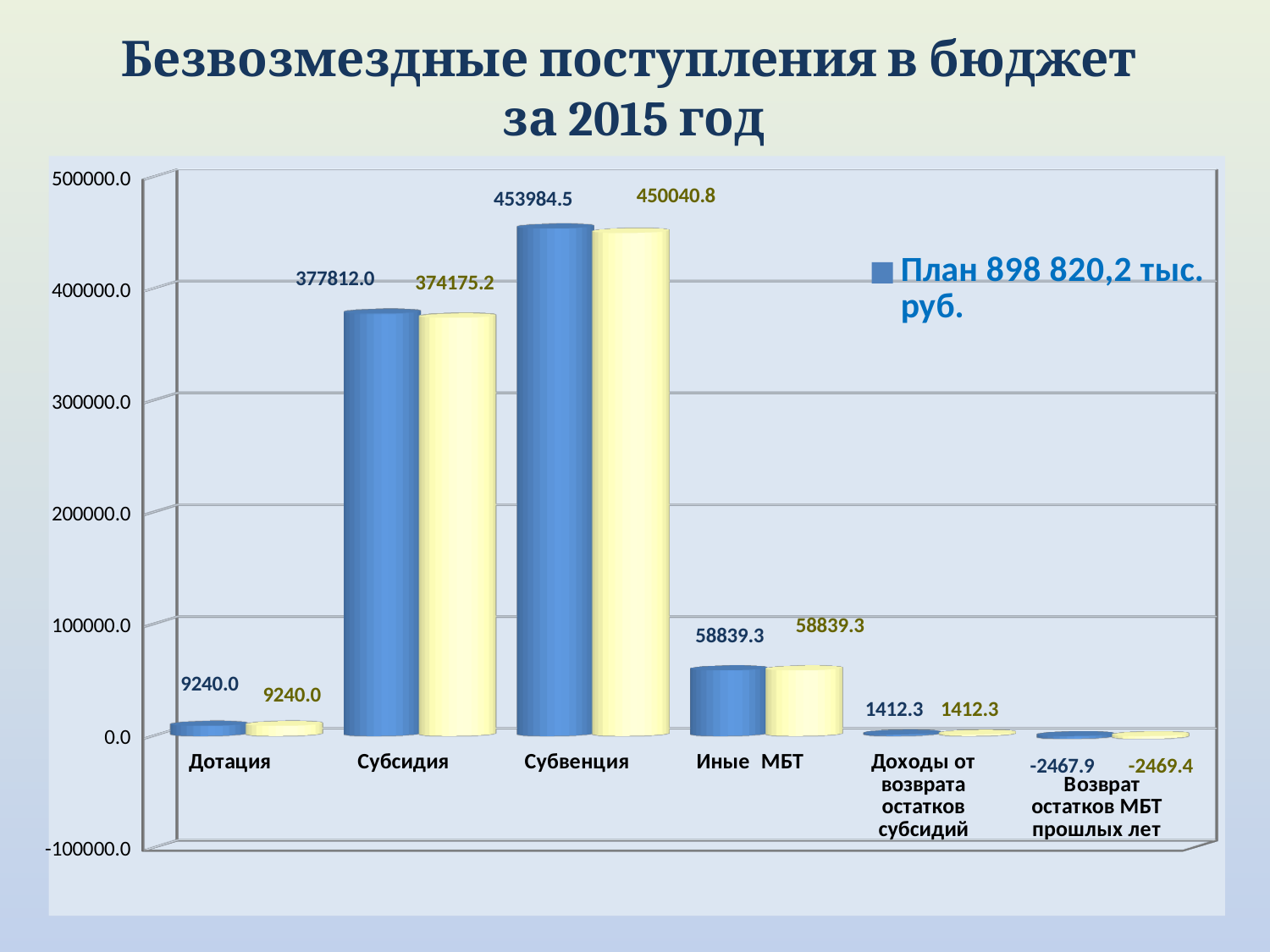
Which category has the highest blue (План) bar? Субвенция What type of chart is shown on the slide? Bar chart Which category has the lowest blue (План) bar? Возврат остатков МБТ прошлых лет How many categories are shown on the x axis of the chart? 6 What is the difference between the blue (План) bar and the yellow bar for Субсидия? 3636.8 Which is larger for Субвенция: the blue (План) bar or the yellow bar? The blue (План) bar What is the value of the blue (План) bar for Субвенция? 453984.5 What is the value of the yellow bar for Возврат остатков МБТ прошлых лет? -2469.4 What is the value of the yellow bar for Субсидия? 374175.2 What is the value of the blue (План) bar for Иные МБТ? 58839.3 What is the legend entry shown for the blue series? План 898 820,2 тыс. руб. Is the blue (План) value for Субсидия greater or less than 400000.0? less